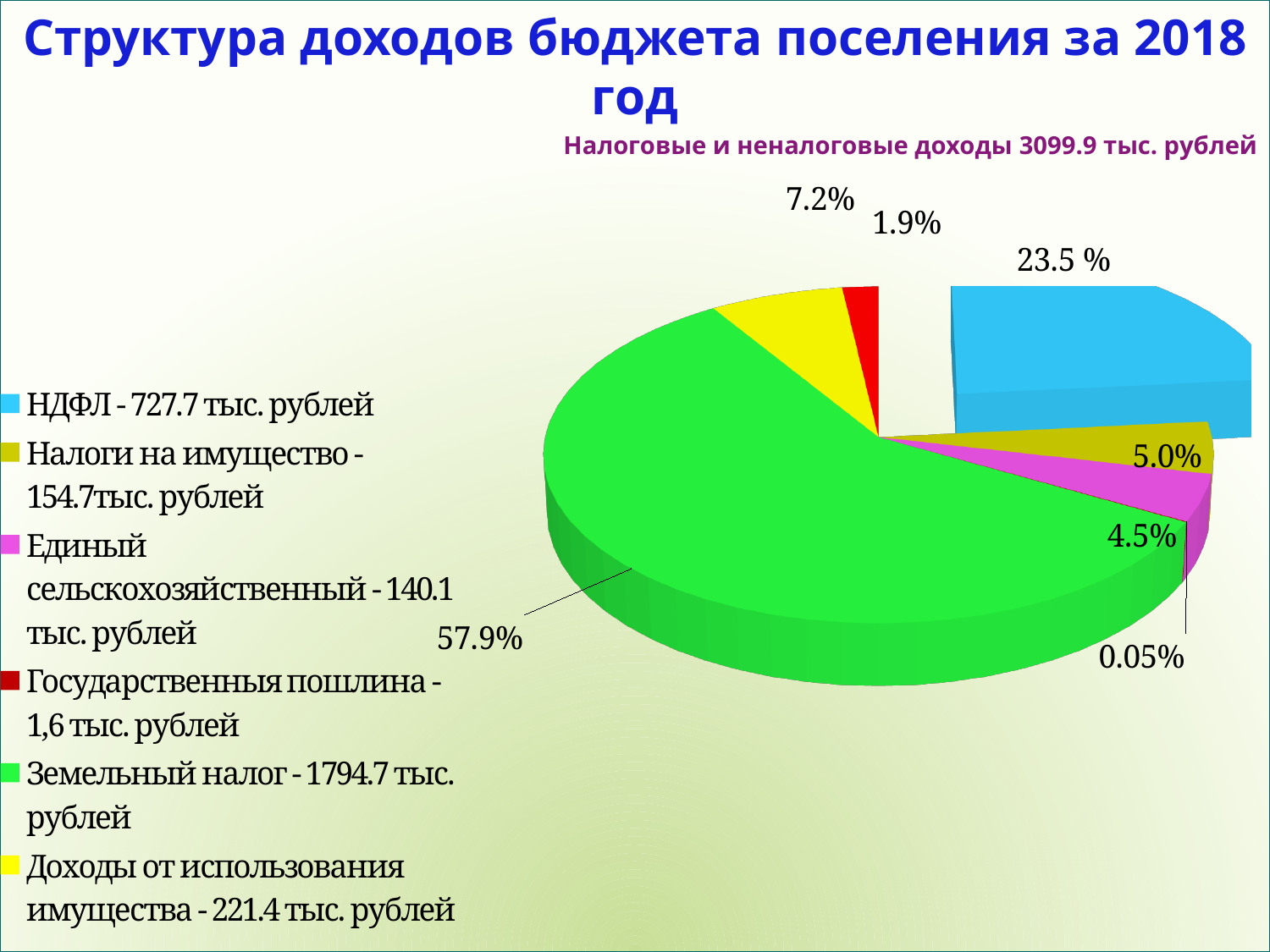
What is the title of the slide's chart? Структура доходов бюджета поселения за 2018 год How many entries does the legend list? 6 Which category has the largest slice of the pie? Земельный налог What share of the pie does Налоги на имущество (the olive slice) represent? 5.0% What amount in тыс. рублей is listed in the legend for НДФЛ? 727.7 тыс. рублей What share of the pie does Земельный налог (the green slice) represent? 57.9% What amount in тыс. рублей is listed in the legend for Земельный налог? 1794.7 тыс. рублей What type of chart is shown on the slide? pie chart What share of the pie does НДФЛ (the blue slice) represent? 23.5 % Which is larger, the share for НДФЛ or the share for Земельный налог? Земельный налог